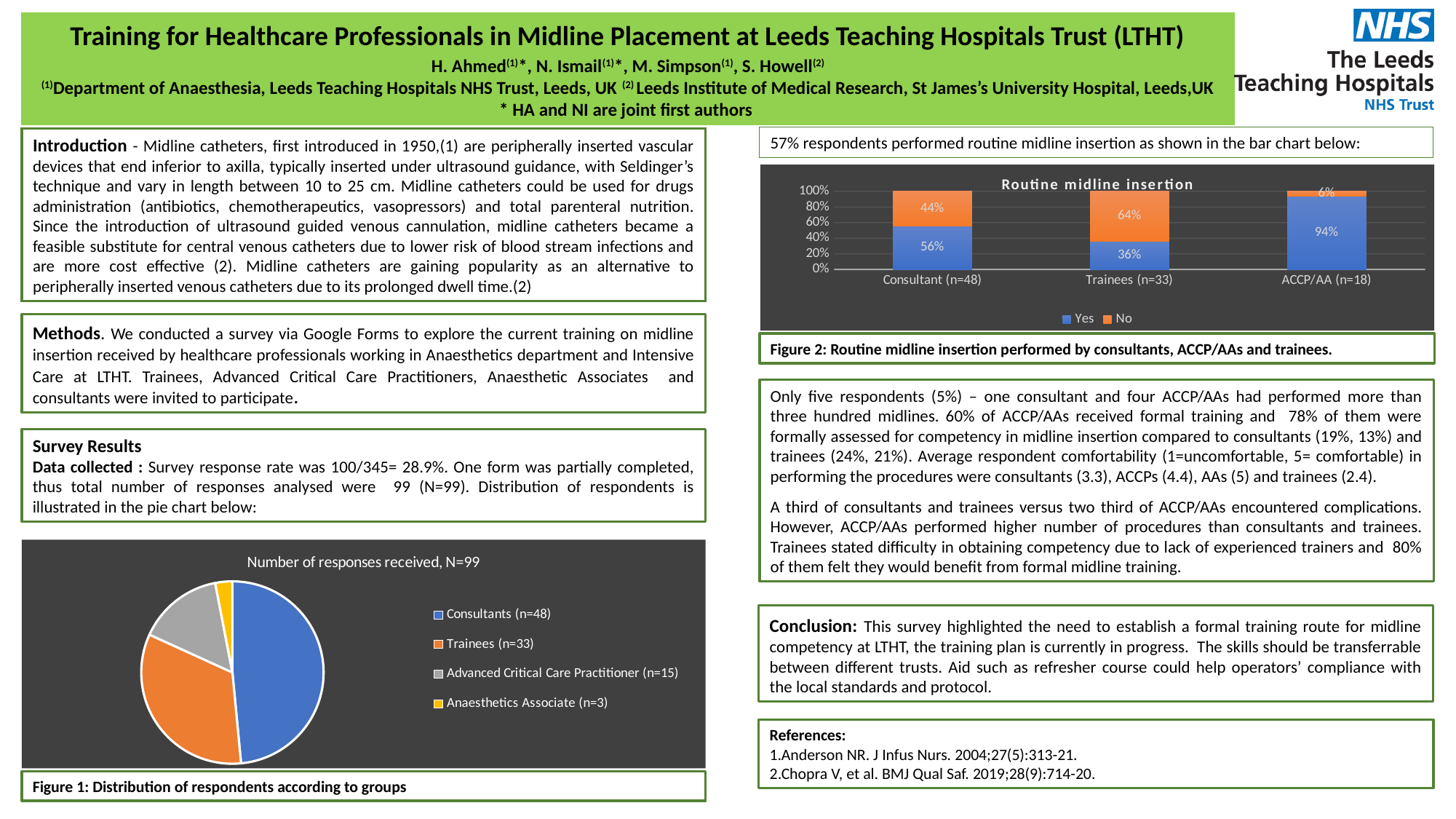
In the pie chart 'Number of responses received, N=99', which group has the largest slice? Consultants (n=48) In the 'Routine midline insertion' bar chart, how many series does the legend list? 2 What type of chart is 'Number of responses received, N=99'? Pie chart In the 'Routine midline insertion' bar chart, is the No value larger for consultants or for trainees? Trainees In the 'Routine midline insertion' bar chart, what percentage of consultants answered Yes? 56% In the 'Routine midline insertion' bar chart, which group has the lowest Yes percentage? Trainees (n=33) In the 'Routine midline insertion' bar chart, what is the total of the stacked bar for Trainees (n=33)? 100% In the 'Routine midline insertion' bar chart, what is the difference between the Yes percentages for consultants and trainees? 20% In the 'Routine midline insertion' bar chart, what is the Yes value for ACCP/AA (n=18)? 94% In the 'Routine midline insertion' bar chart, what percentage of trainees answered No? 64% In the 'Routine midline insertion' bar chart, which group has the highest Yes percentage? ACCP/AA (n=18) How many categories does the pie chart 'Number of responses received, N=99' show? 4